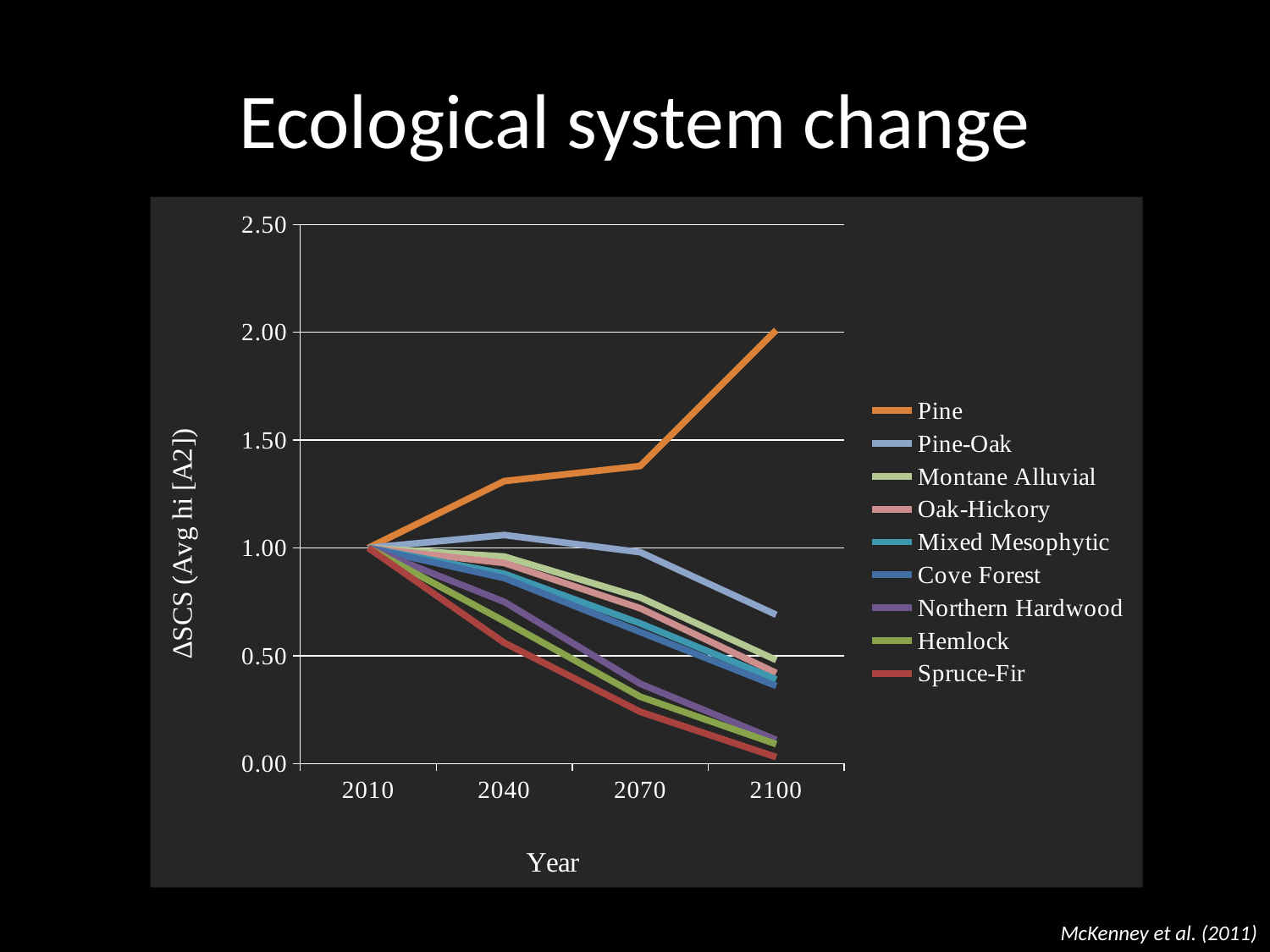
Which series has the lowest value in 2100? Spruce-Fir What is the title of the x axis? Year Is the value for Pine in 2070 greater or less than 1.50? less In 2100, which is larger: the value for Pine-Oak or the value for Spruce-Fir? Pine-Oak What value do all the series share in 2010? 1.00 Does the Spruce-Fir series rise or fall from 2010 to 2100? falls How many years are marked on the x axis? 4 Which series has the highest value in 2100? Pine Is the value for Pine-Oak in 2100 greater or less than 0.50? greater Does the Pine series rise or fall from 2010 to 2100? rises How many series does the legend list? 9 What kind of chart is shown on the slide? line chart